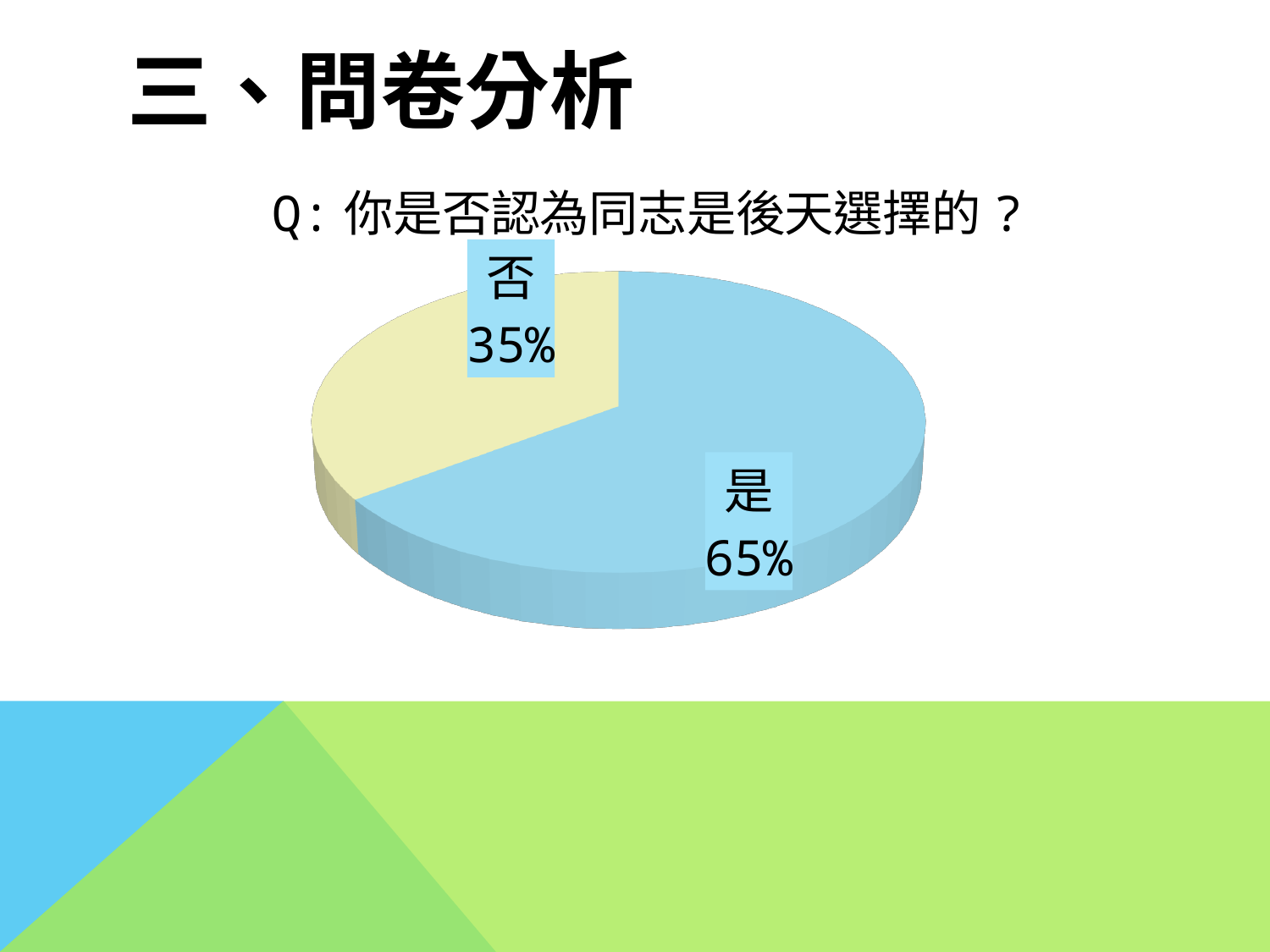
Which is larger, the share for 是 or the share for 否? 是 What percentage of respondents answered 否? 35% What percentage of respondents answered 是? 65% What question is the pie chart about, as shown in its title? Q: 你是否認為同志是後天選擇的？ What colour is the 是 slice of the pie chart? blue What is the difference in percentage points between 是 and 否? 30 What is the share of the pie taken by the 否 slice? 35% How many slices does the pie chart have? 2 What kind of chart is shown on the slide? pie chart Which answer has the smallest share of the pie? 否 Which answer has the largest share of the pie? 是